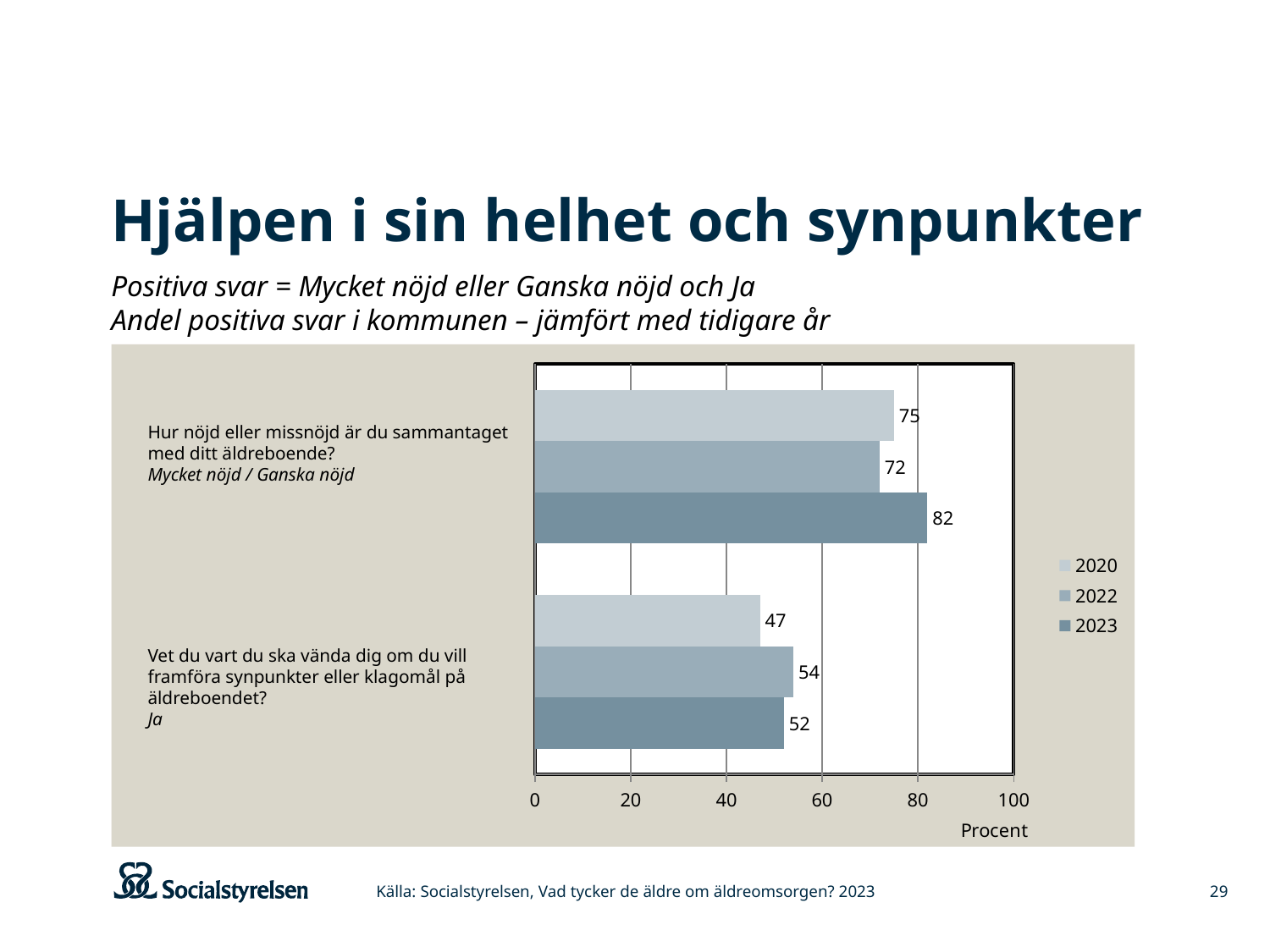
Which is larger for 'Vet du vart du ska vända dig om du vill framföra synpunkter eller klagomål på äldreboendet?': the 2020 value or the 2023 value? 2023 How many questions (categories) are shown in the chart? 2 What is the 2020 value for 'Vet du vart du ska vända dig om du vill framföra synpunkter eller klagomål på äldreboendet?' 47 What kind of chart is shown on the slide? bar chart Which year has the lowest value for 'Hur nöjd eller missnöjd är du sammantaget med ditt äldreboende?' 2022 What is the 2022 value for 'Hur nöjd eller missnöjd är du sammantaget med ditt äldreboende?' 72 How many series does the legend list? 3 What is the difference between the 2023 and 2022 values for 'Hur nöjd eller missnöjd är du sammantaget med ditt äldreboende?' 10 What is the label of the horizontal axis? Procent What is the 2023 value for 'Hur nöjd eller missnöjd är du sammantaget med ditt äldreboende?' 82 Is the 2023 value for 'Hur nöjd eller missnöjd är du sammantaget med ditt äldreboende?' greater or less than 80? greater Which year has the highest value for 'Vet du vart du ska vända dig om du vill framföra synpunkter eller klagomål på äldreboendet?' 2022